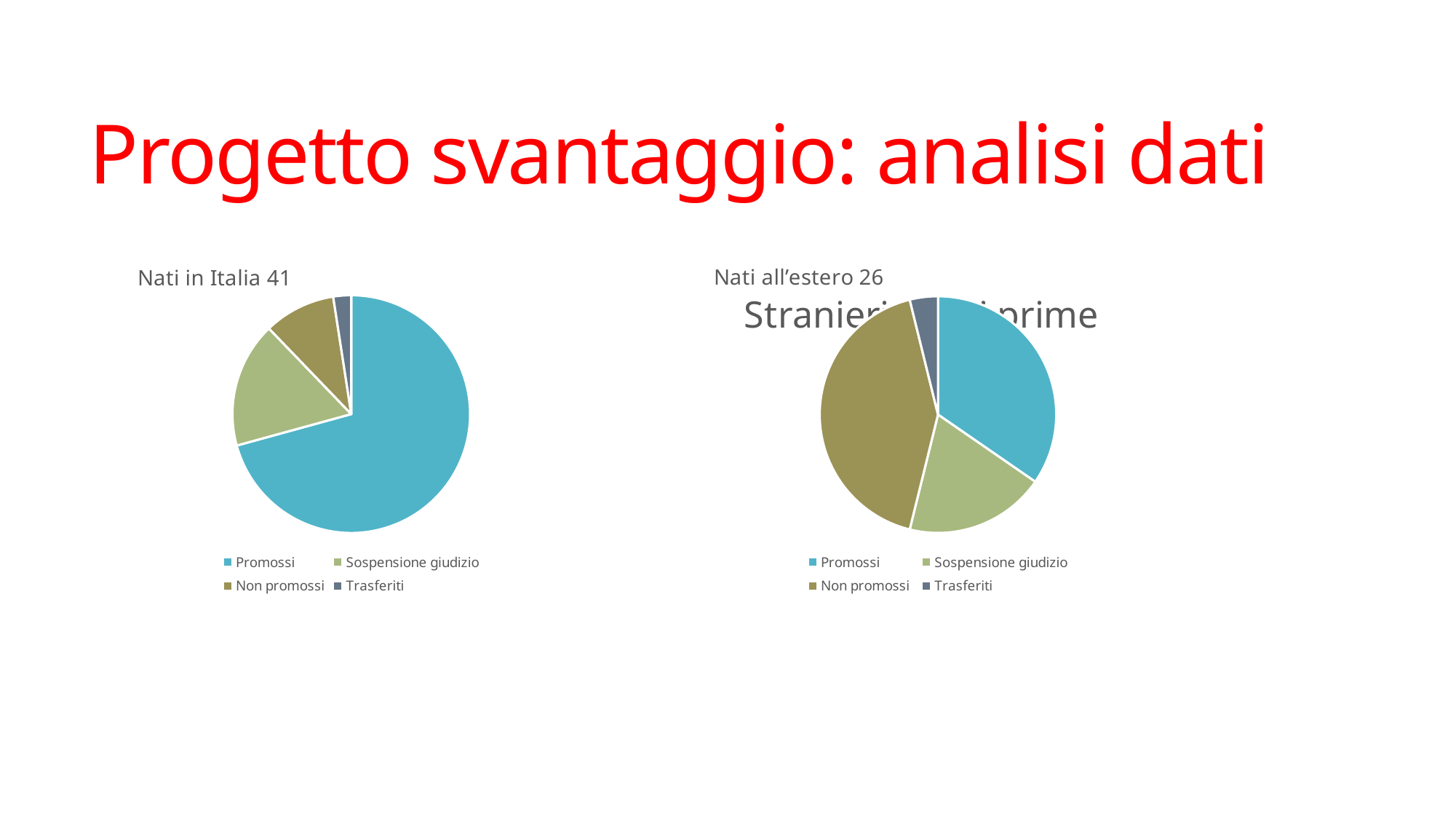
In the 'Nati all'estero 26' chart, which slice is larger: Promossi or Sospensione giudizio? Promossi In the 'Nati in Italia 41' chart, which category has the smallest slice? Trasferiti In the 'Nati in Italia 41' chart, which category has the largest slice? Promossi What is the title of the pie chart on the left of the slide? Nati in Italia 41 In the 'Nati all'estero 26' chart, which category has the largest slice? Non promossi How many entries does the legend of the 'Nati all'estero 26' chart list? 4 What kind of chart is the 'Nati in Italia 41' chart? pie chart What kind of chart is the 'Nati all'estero 26' chart? pie chart In the 'Nati all'estero 26' chart, which category has the smallest slice? Trasferiti In the 'Nati all'estero 26' chart, which slice is larger: Promossi or Non promossi? Non promossi How many slices does the 'Nati in Italia 41' pie chart have? 4 In the 'Nati in Italia 41' chart, which slice is larger: Sospensione giudizio or Non promossi? Sospensione giudizio